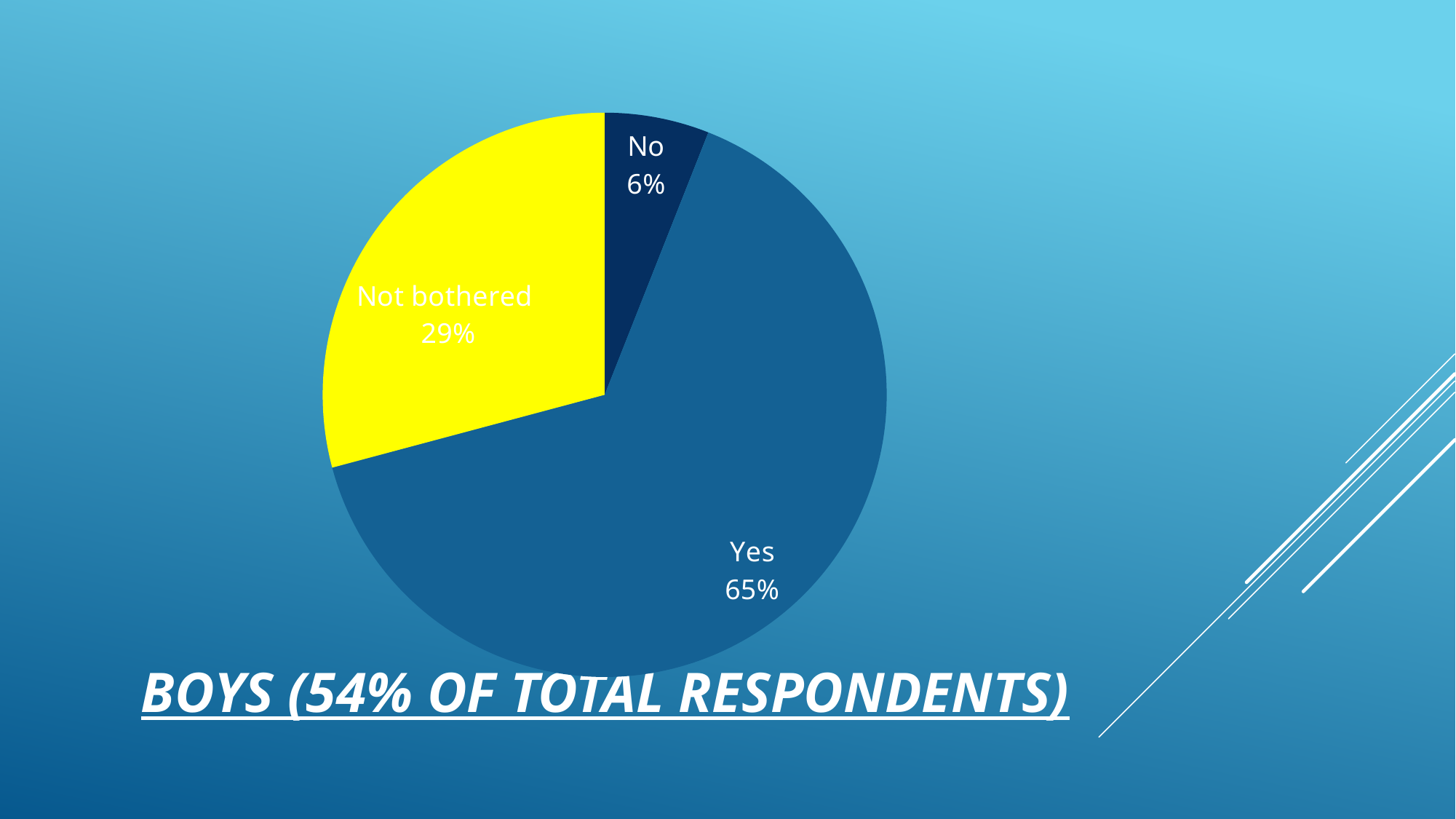
What colour is the "Not bothered" slice? Yellow What percentage of the pie is the "Not bothered" slice? 29% Which slice is larger, "Not bothered" or "No"? Not bothered Which slice of the pie is the largest? Yes What is the title text shown below the pie chart? BOYS (54% OF TOTAL RESPONDENTS) What kind of chart is shown on the slide? Pie chart What percentage of the pie is the "Yes" slice? 65% What is the difference in percentage points between the "Yes" and "Not bothered" slices? 36 What percentage of the pie is the "No" slice? 6% Which slice of the pie is the smallest? No What is the difference in percentage points between the "Not bothered" and "No" slices? 23 How many slices does the pie chart have? 3